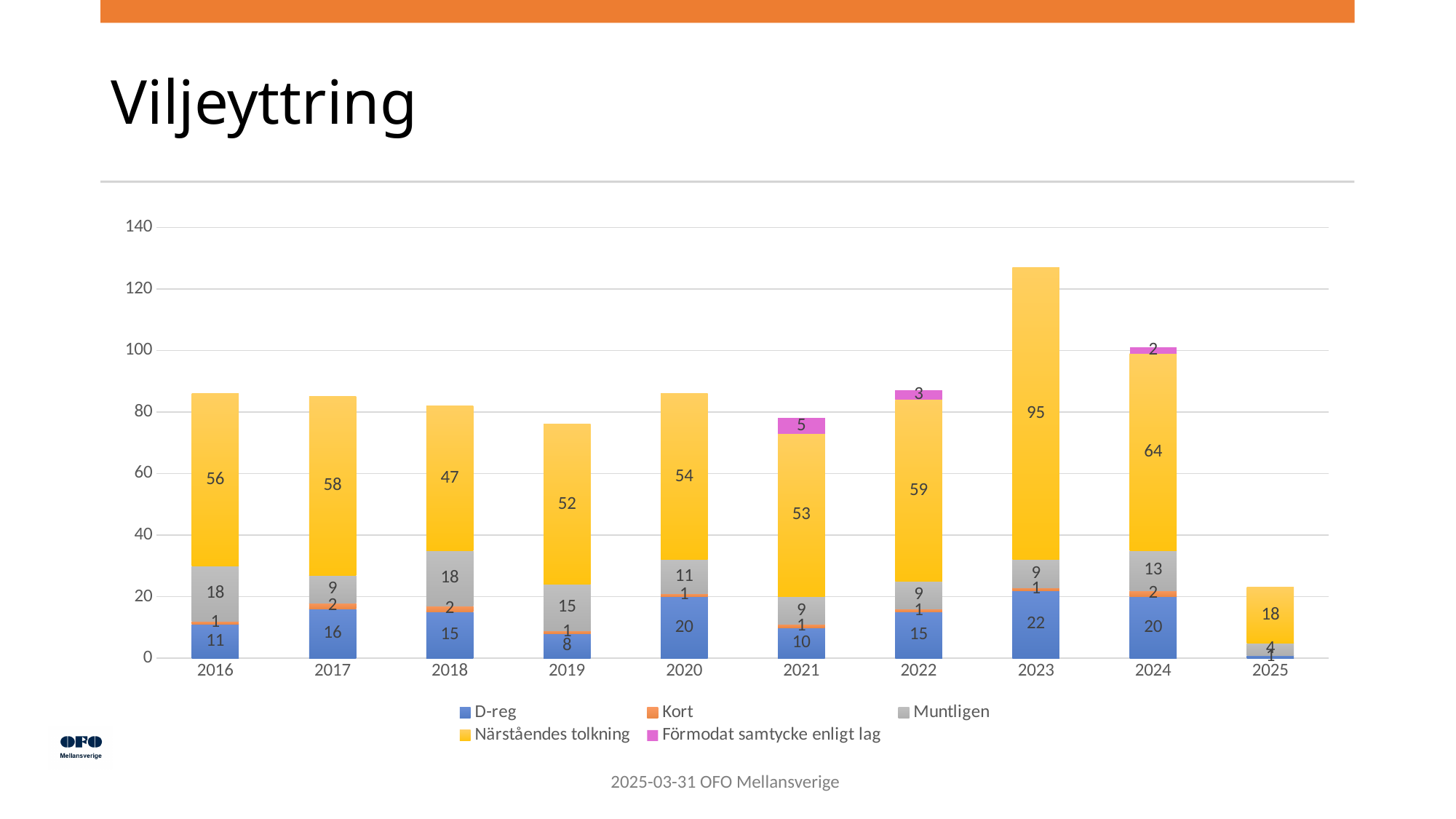
Which year has the tallest stacked bar? 2023 What is the value of Närståendes tolkning for 2023? 95 What is the value of Förmodat samtycke enligt lag for 2021? 5 How many series does the legend list? 5 What is the D-reg value for 2020? 20 Is the total of the 2023 bar greater or less than 120? greater Which is larger, the D-reg value for 2023 or for 2019? 2023 What is the Muntligen value for 2018? 18 Which year has the shortest stacked bar? 2025 What is the total of the stacked bar for 2016? 86 How many years are shown on the x axis? 10 What is the difference between the Närståendes tolkning values for 2023 and 2024? 31